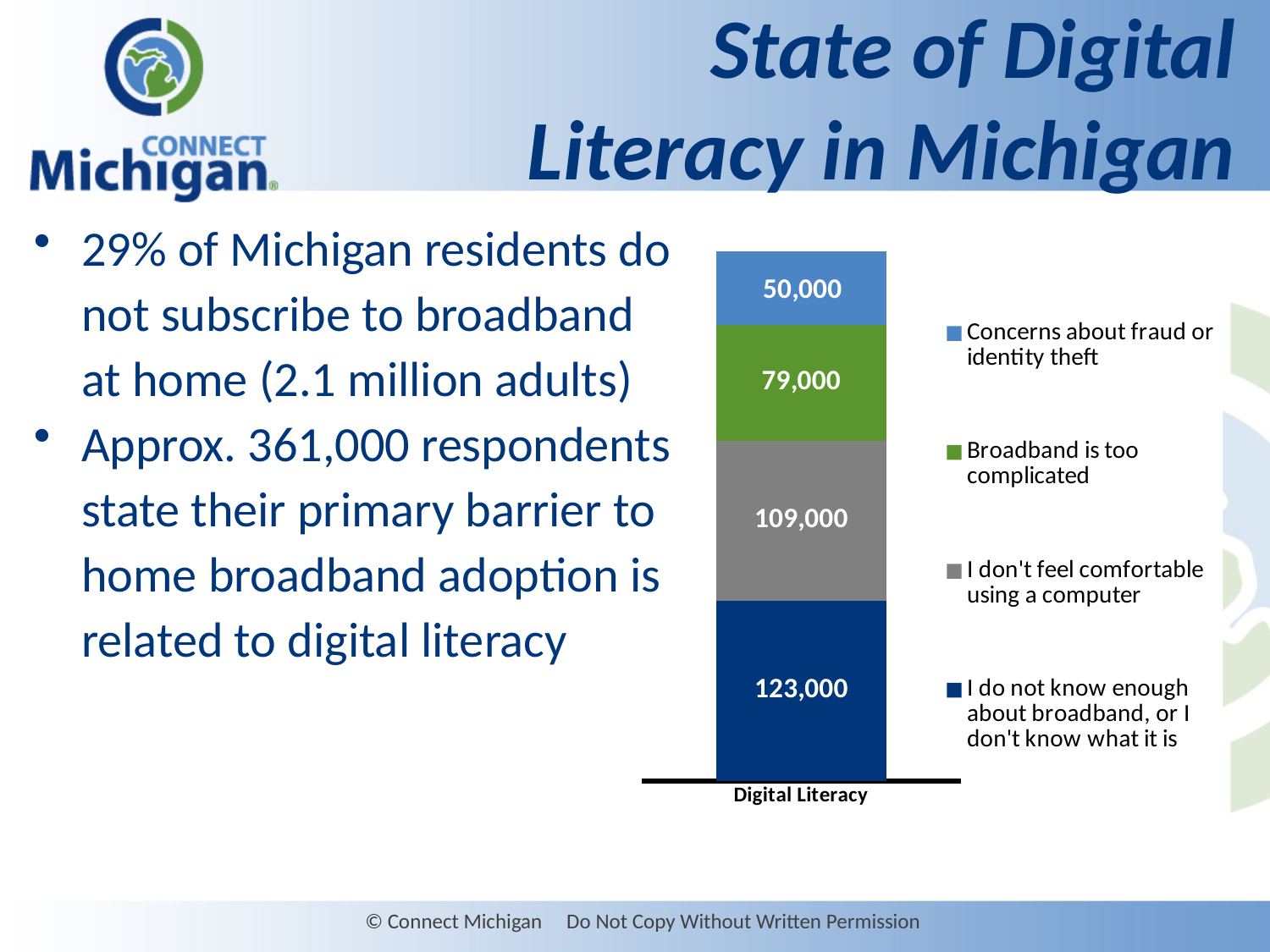
How many series does the legend list? 4 What is the total of the Digital Literacy stacked bar? 361,000 What is the category label shown on the x axis of the chart? Digital Literacy Which is larger: "Broadband is too complicated" or "I don't feel comfortable using a computer"? I don't feel comfortable using a computer What is the value for "Broadband is too complicated"? 79,000 What kind of chart is shown on the slide? Stacked bar chart What is the value for "Concerns about fraud or identity theft"? 50,000 What is the value for "I do not know enough about broadband, or I don't know what it is"? 123,000 Which series has the largest value in the Digital Literacy bar? I do not know enough about broadband, or I don't know what it is Which series has the smallest value in the Digital Literacy bar? Concerns about fraud or identity theft What is the difference between the values for "I do not know enough about broadband, or I don't know what it is" and "Concerns about fraud or identity theft"? 73,000 What is the value for "I don't feel comfortable using a computer"? 109,000